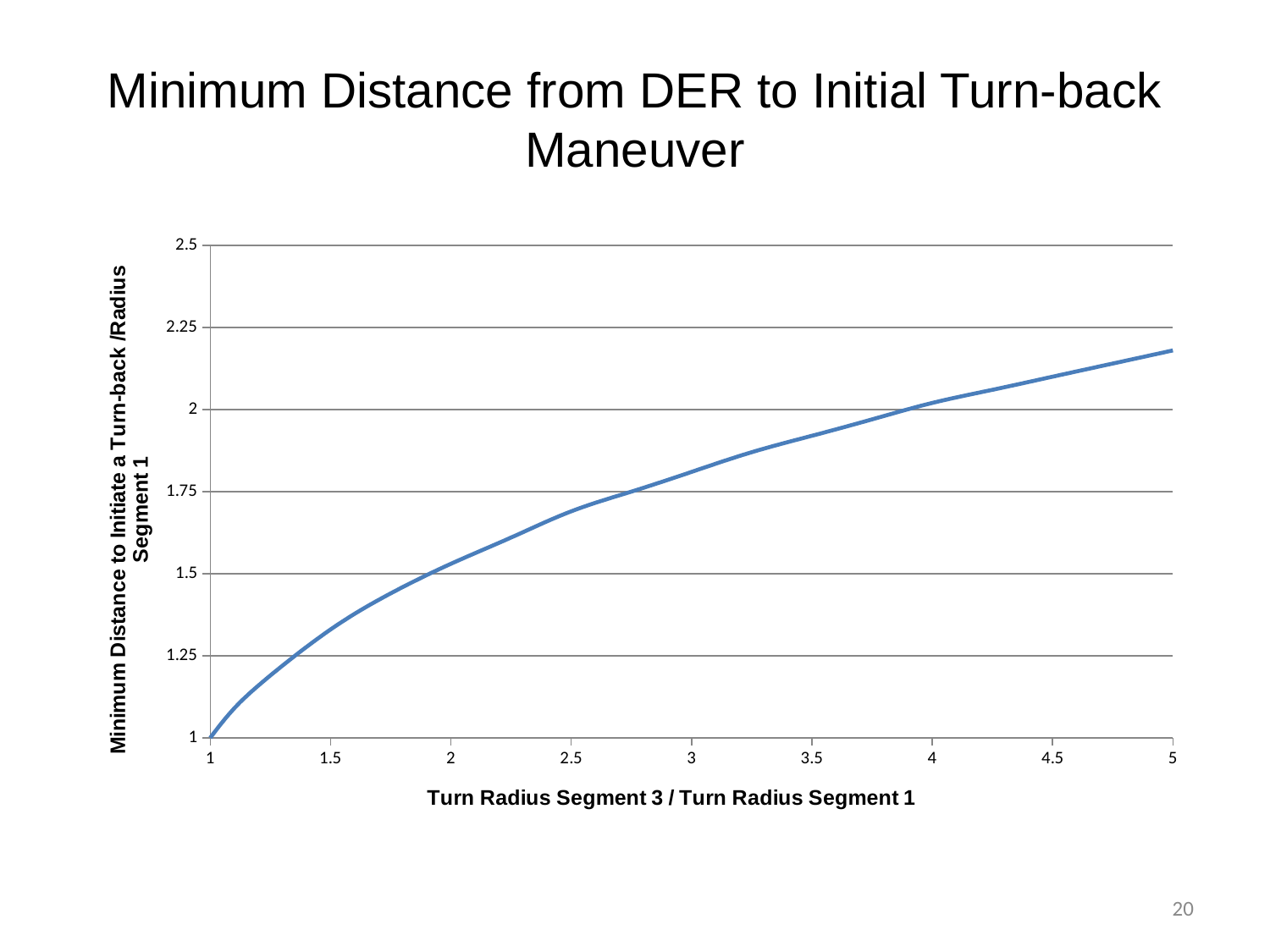
What is the title of the x axis? Turn Radius Segment 3 / Turn Radius Segment 1 Is the value at Turn Radius Segment 3 / Turn Radius Segment 1 = 1.5 greater or less than 1.5? less What kind of chart is shown on the slide? line chart Is the value at Turn Radius Segment 3 / Turn Radius Segment 1 = 3 greater or less than 1.75? greater Is the value at Turn Radius Segment 3 / Turn Radius Segment 1 = 3.5 greater or less than 2? less Which is larger: the value at Turn Radius Segment 3 / Turn Radius Segment 1 = 2 or at = 4? at 4 Does the plotted value rise or fall as Turn Radius Segment 3 / Turn Radius Segment 1 increases from 1 to 5? rise What is the value of Minimum Distance to Initiate a Turn-back / Radius Segment 1 when Turn Radius Segment 3 / Turn Radius Segment 1 is 1? 1